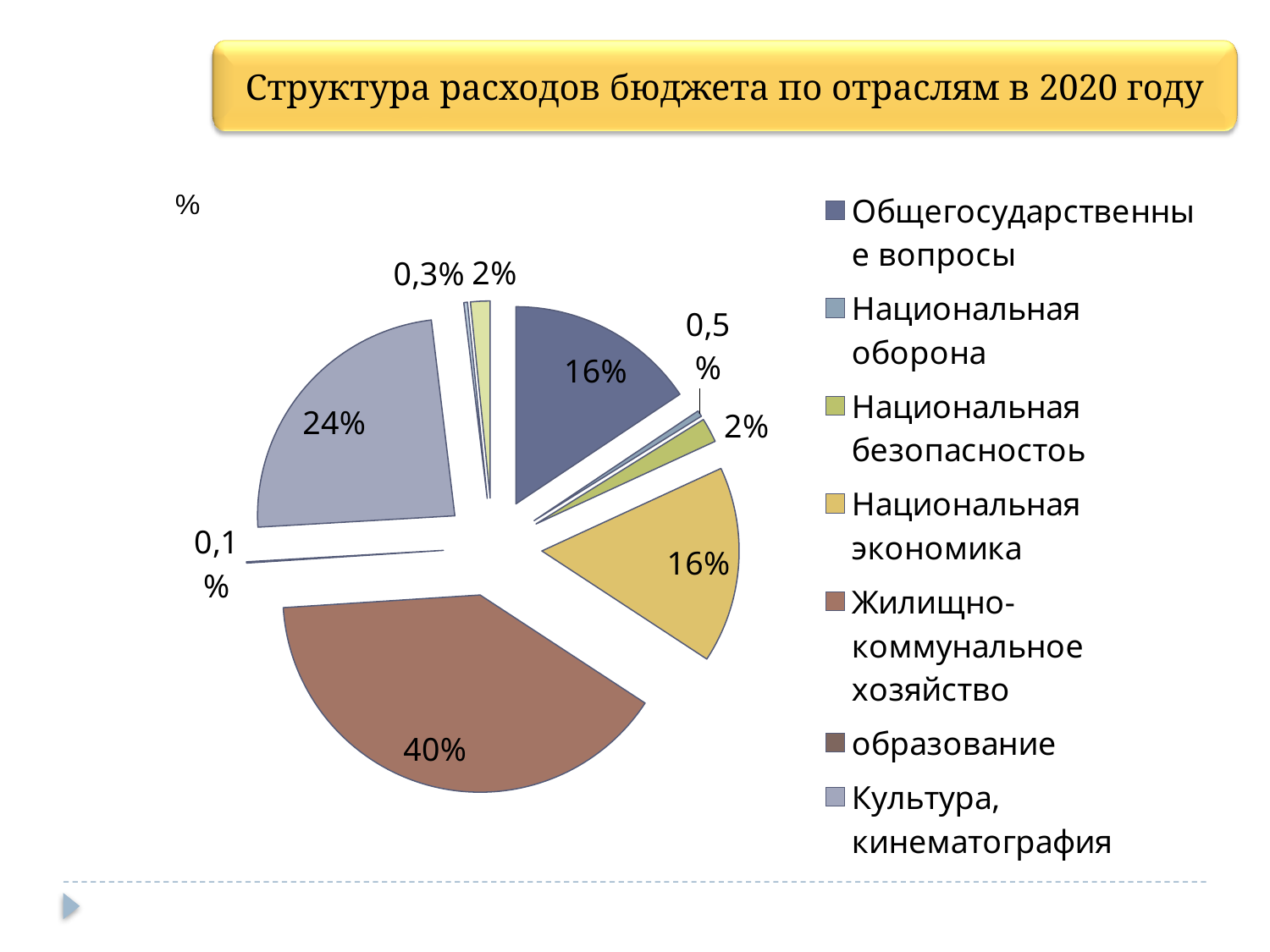
What kind of chart is shown on the slide? pie chart How many entries does the legend list? 7 What is the difference between the shares of Жилищно-коммунальное хозяйство and Культура, кинематография? 16% What share of the pie does Национальная экономика have? 16% What share of the pie does Жилищно-коммунальное хозяйство have? 40% What is the title of the chart? Структура расходов бюджета по отраслям в 2020 году How many slices are labelled on the pie chart? 9 Which is larger, the share of Культура, кинематография or the share of Национальная экономика? Культура, кинематография What share of the pie does Культура, кинематография have? 24% Which category has the largest share of the pie? Жилищно-коммунальное хозяйство